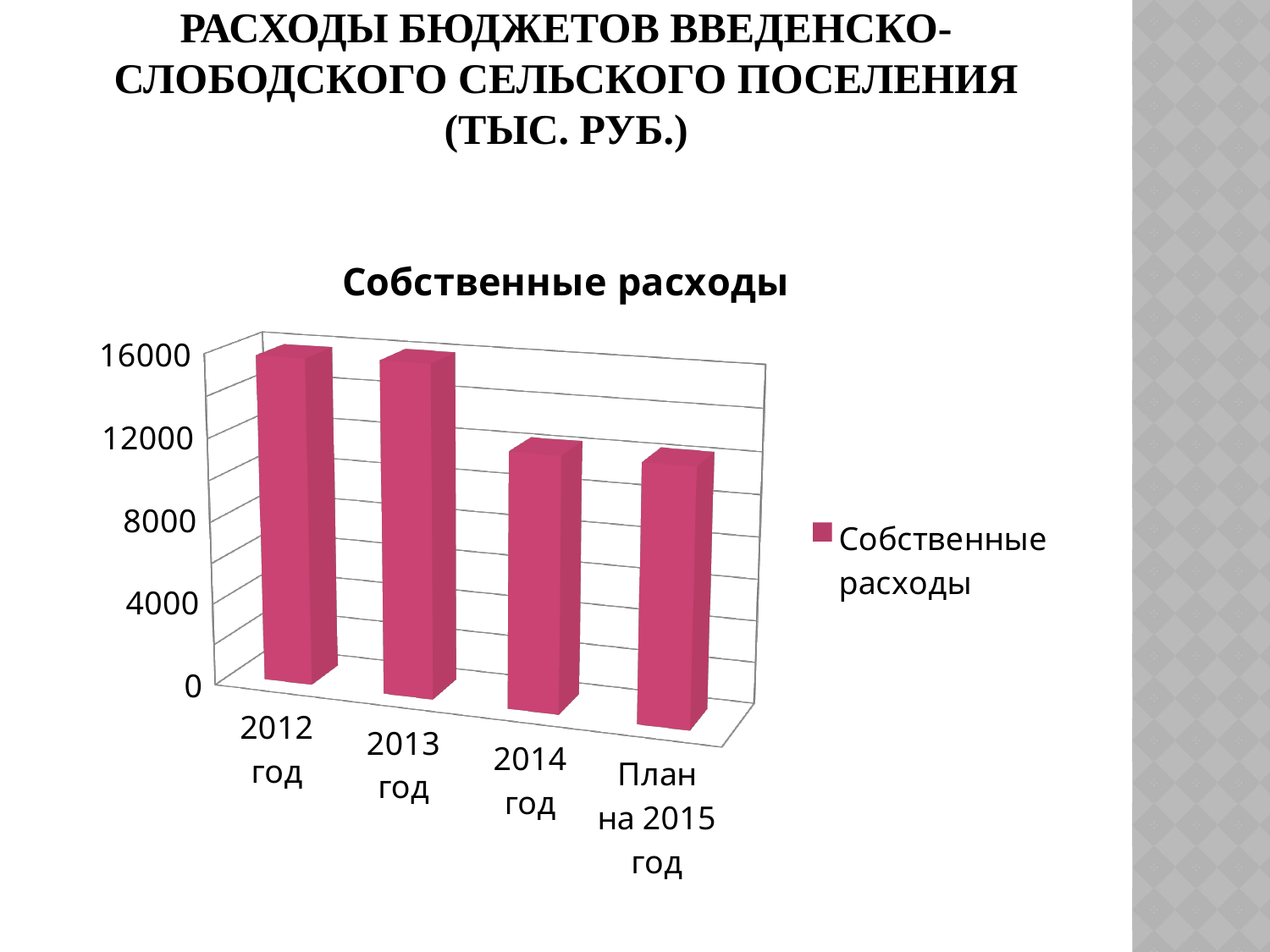
Is the value for 2014 год greater or less than 8000? greater How many series does the chart legend list? 1 Do the values generally rise or fall from 2012 год to План на 2015 год? fall Which is larger, the value for 2012 год or the value for 2014 год? 2012 год What kind of chart is shown on the slide? bar chart Which is larger, the value for 2013 год or the value for План на 2015 год? 2013 год How many categories are plotted on the x axis of the chart? 4 Is the value for 2012 год greater or less than 12000? greater What is the title of the chart? Собственные расходы Is the value for 2013 год greater or less than 12000? greater